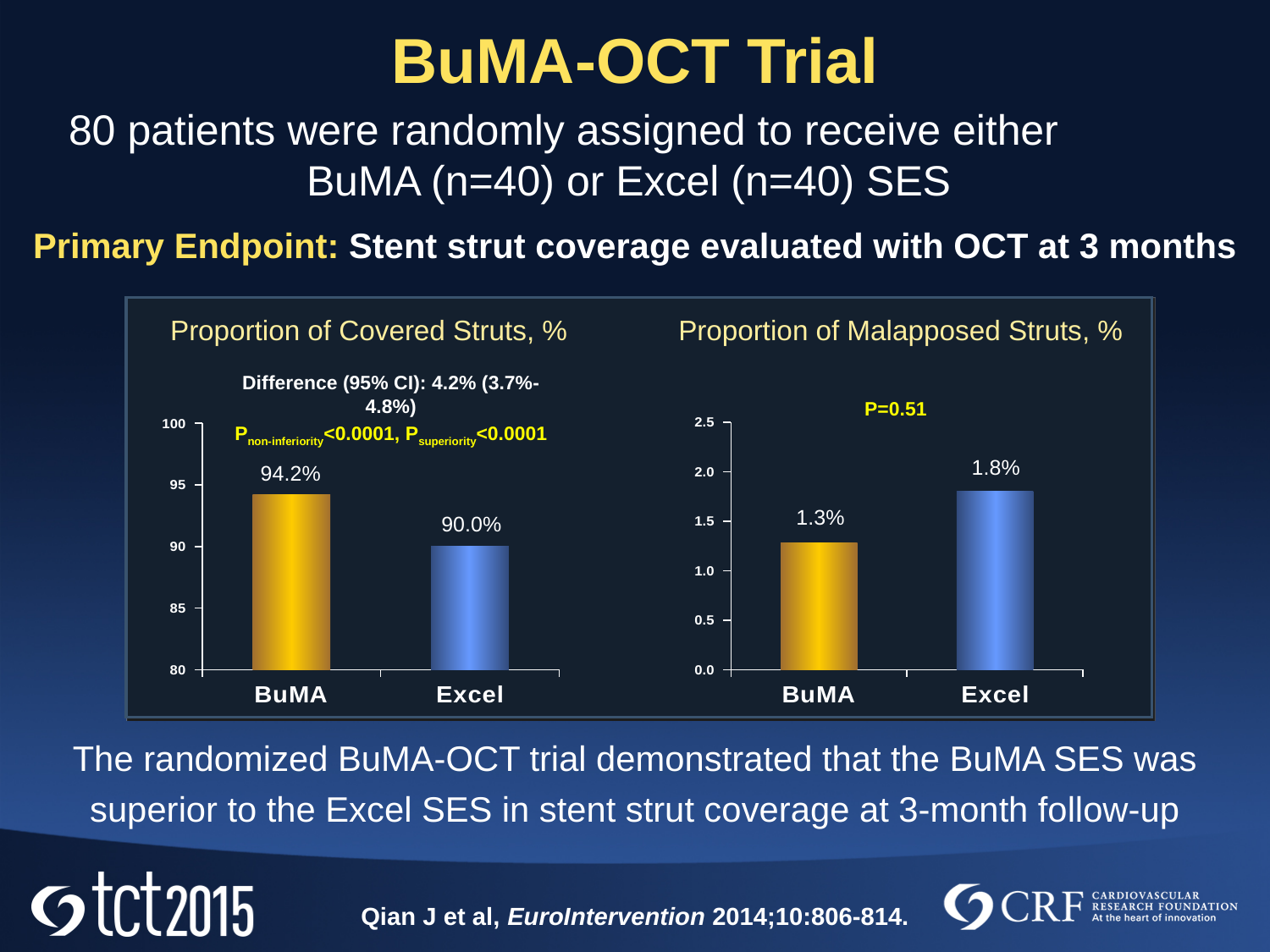
In the 'Proportion of Malapposed Struts, %' chart, what is the value for BuMA? 1.3% In the 'Proportion of Covered Struts, %' chart, which category has the highest value? BuMA In the 'Proportion of Malapposed Struts, %' chart, what is the difference between the Excel and BuMA values? 0.5% In the 'Proportion of Covered Struts, %' chart, what is the value for Excel? 90.0% In the 'Proportion of Malapposed Struts, %' chart, what is the value for Excel? 1.8% In the 'Proportion of Covered Struts, %' chart, how many categories are shown on the x axis? 2 In the 'Proportion of Malapposed Struts, %' chart, which is larger, the value for BuMA or the value for Excel? Excel In the 'Proportion of Malapposed Struts, %' chart, which category has the lowest value? BuMA What kind of chart is the 'Proportion of Malapposed Struts, %' chart? bar chart In the 'Proportion of Covered Struts, %' chart, what is the difference between the BuMA and Excel values? 4.2% In the 'Proportion of Covered Struts, %' chart, what is the value for BuMA? 94.2% In the 'Proportion of Malapposed Struts, %' chart, what P value is printed above the bars? P=0.51